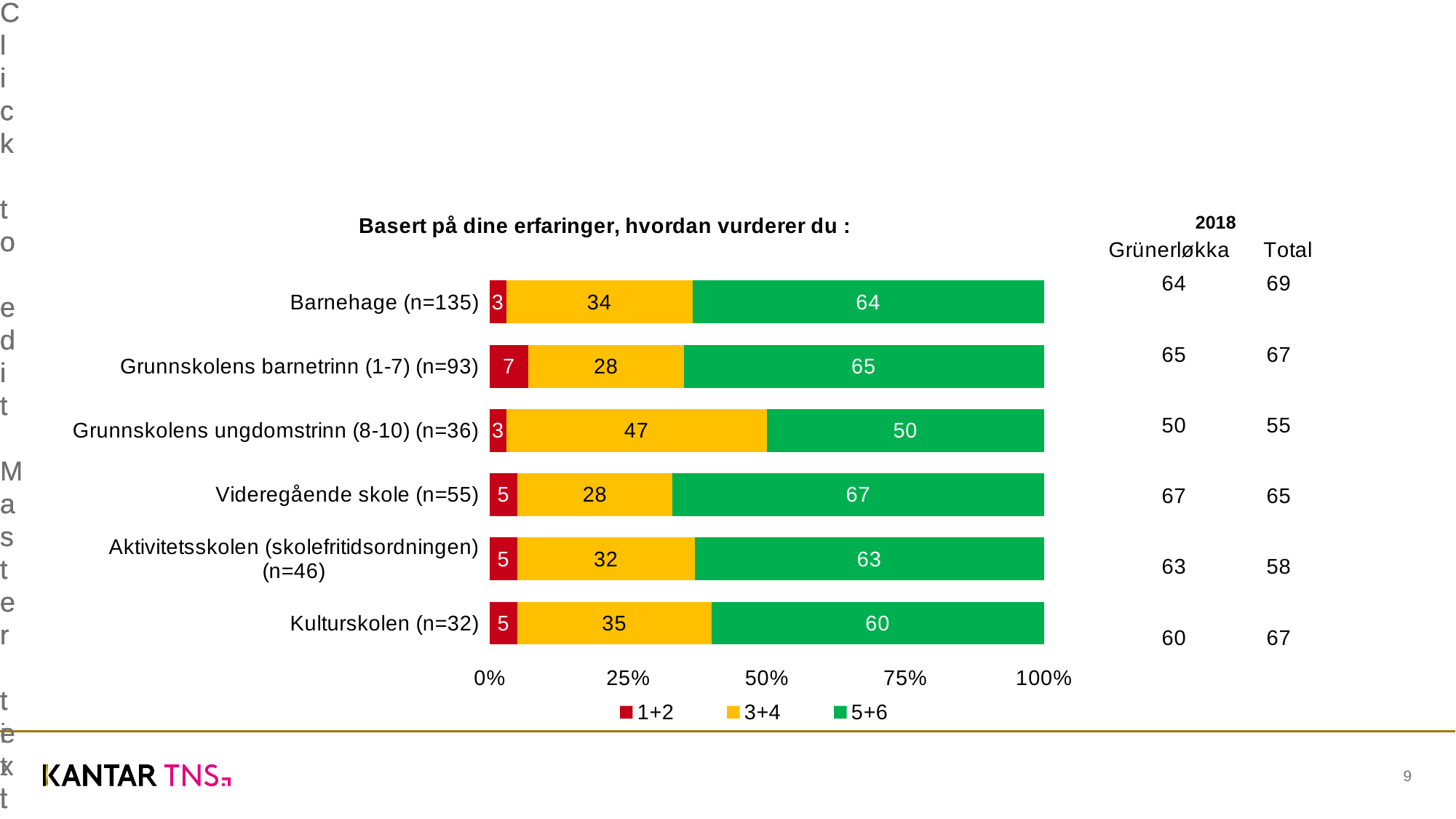
Which is larger, the 3+4 value for Kulturskolen (n=32) or for Aktivitetsskolen (skolefritidsordningen) (n=46)? Kulturskolen (n=32) Which category has the highest value for the 5+6 series? Videregående skole (n=55) What is the total of the stacked bar for Grunnskolens ungdomstrinn (8-10) (n=36)? 100 Which category has the lowest value for the 5+6 series? Grunnskolens ungdomstrinn (8-10) (n=36) What is the difference between the 5+6 values for Videregående skole (n=55) and Kulturskolen (n=32)? 7 What is the value of the 5+6 series for Barnehage (n=135)? 64 What is the value of the 3+4 series for Grunnskolens ungdomstrinn (8-10) (n=36)? 47 How many categories are shown in the chart? 6 What is the title of the chart? Basert på dine erfaringer, hvordan vurderer du : What is the value of the 1+2 series for Grunnskolens barnetrinn (1-7) (n=93)? 7 How many series does the legend list? 3 What kind of chart is shown on the slide? Stacked bar chart